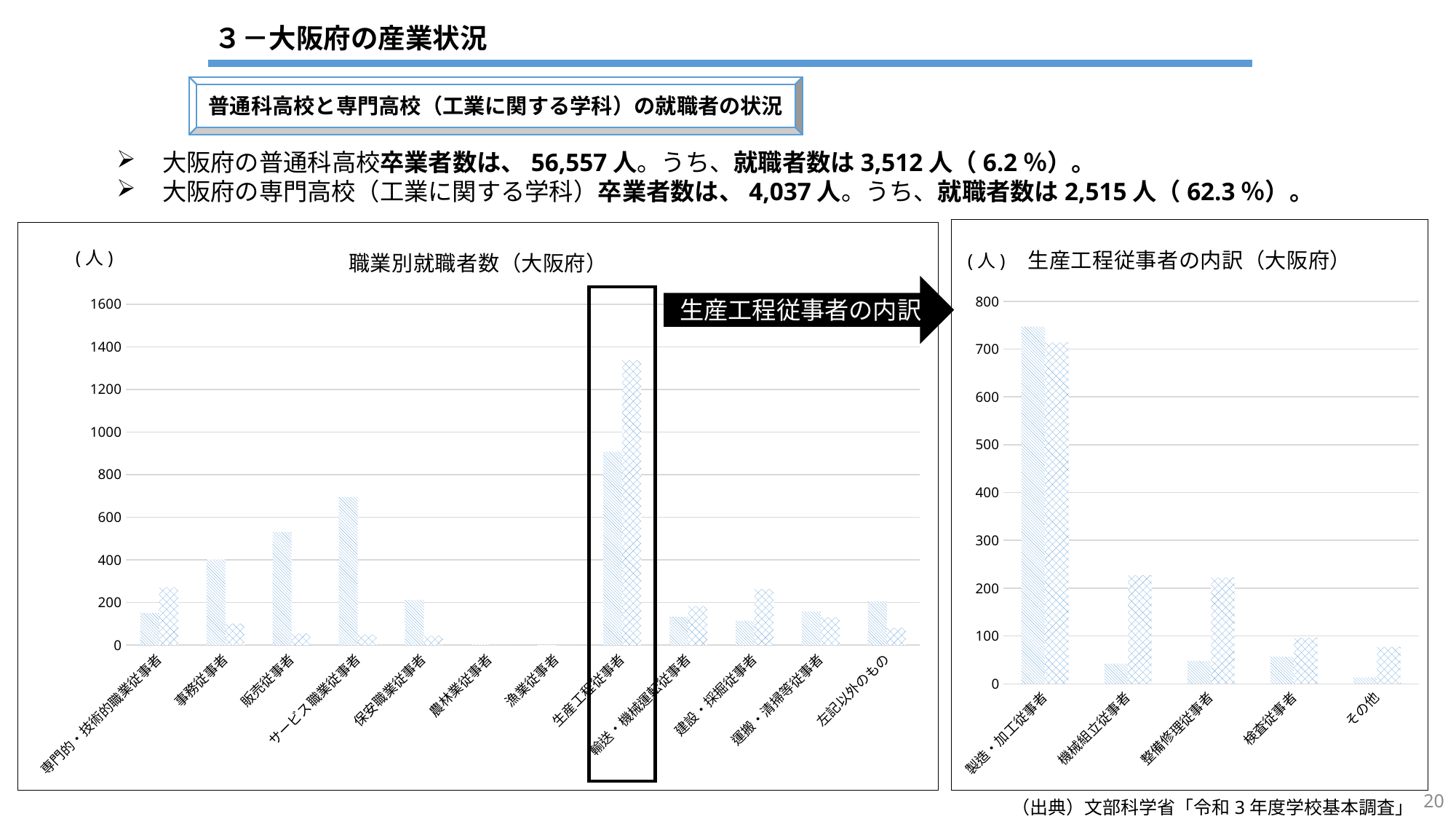
In the right chart 生産工程従事者の内訳（大阪府）, is the taller bar for 機械組立従事者 greater or less than 200? greater In the right chart 生産工程従事者の内訳（大阪府）, is the taller bar for 製造・加工従事者 greater or less than 700? greater In the left chart 職業別就職者数（大阪府）, is the taller bar for 生産工程従事者 greater or less than 1200? greater What kind of chart is the left chart titled 職業別就職者数（大阪府）? bar chart In the left chart 職業別就職者数（大阪府）, which category has the tallest bar? 生産工程従事者 How many occupation categories are shown on the x axis of the left chart 職業別就職者数（大阪府）? 12 In the right chart 生産工程従事者の内訳（大阪府）, which category has the tallest bar? 製造・加工従事者 In the left chart 職業別就職者数（大阪府）, which has a taller highest bar: 事務従事者 or サービス職業従事者? サービス職業従事者 How many categories are shown on the x axis of the right chart 生産工程従事者の内訳（大阪府）? 5 What unit is shown at the top of the y axis of the left chart 職業別就職者数（大阪府）? （人）